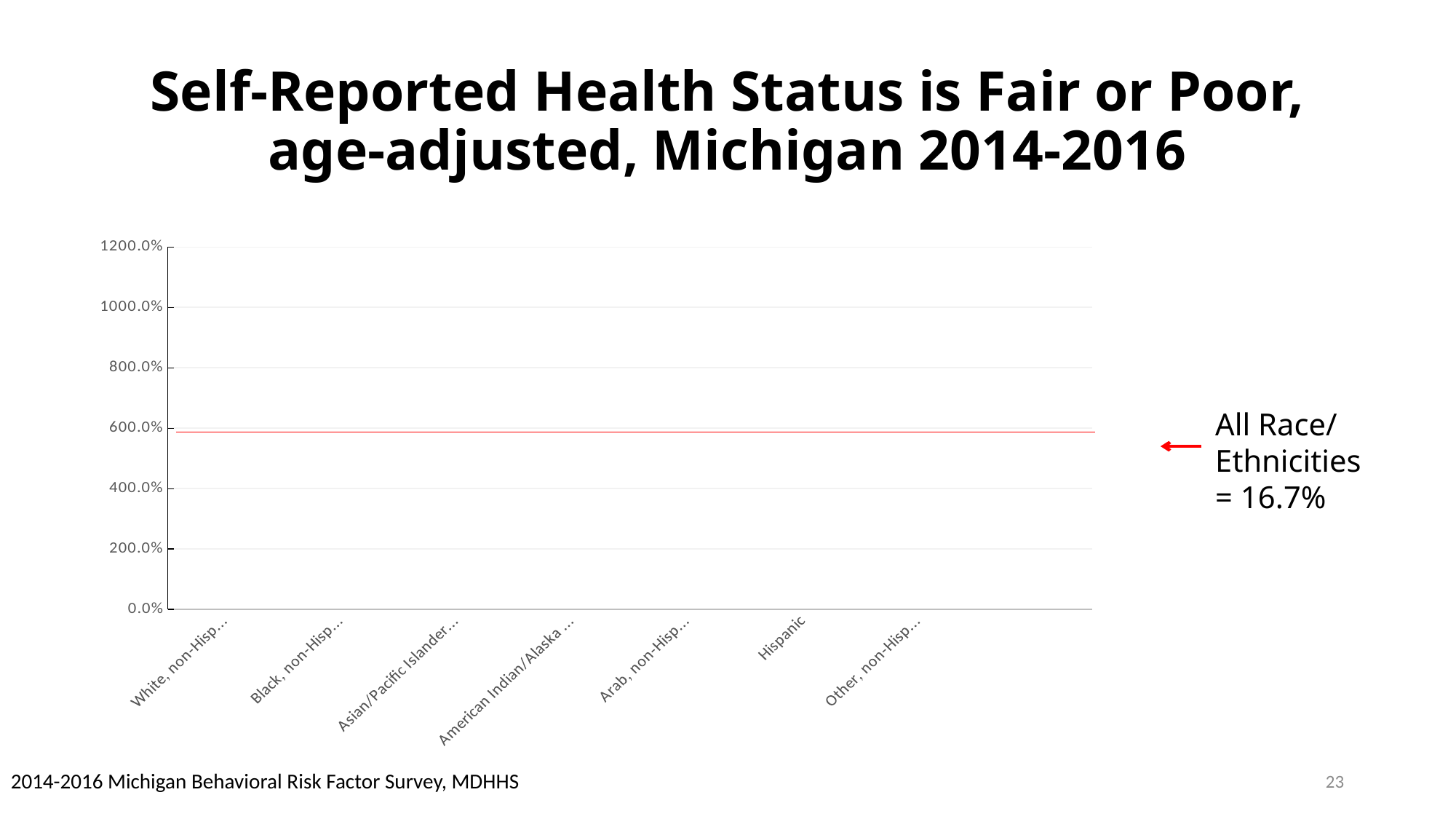
What is the title of the chart on this slide? Self-Reported Health Status is Fair or Poor, age-adjusted, Michigan 2014-2016 What value does the slide give for All Race/Ethnicities, indicated by the red arrow? 16.7% Which category label appears fully (not truncated) on the x axis of the chart? Hispanic How many race/ethnicity categories are listed along the x axis of the chart? 7 What data source is cited at the bottom of the slide? 2014-2016 Michigan Behavioral Risk Factor Survey, MDHHS What is the highest tick label shown on the y axis of the chart? 1200.0%